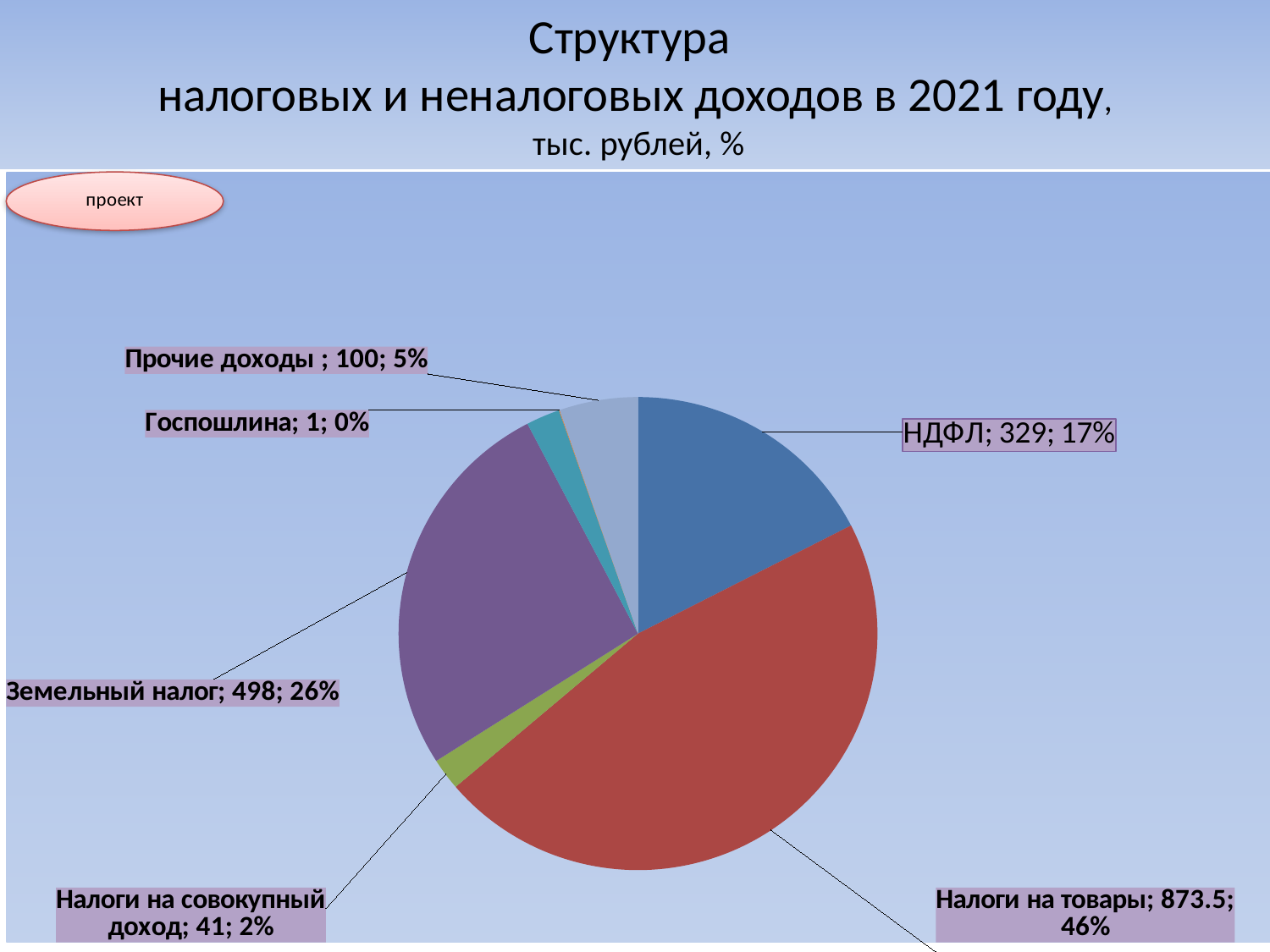
What is the value for Налоги на товары? 873.5 Which category has the smallest slice? Госпошлина What is the value for Земельный налог? 498 What share of the pie does Земельный налог represent? 26% What is the value for Налоги на совокупный доход? 41 Which category has the largest slice? Налоги на товары Which is larger, the value for НДФЛ or the value for Прочие доходы? НДФЛ How many slices does the pie chart have? 7 What is the value for НДФЛ? 329 What share of the pie does Прочие доходы represent? 5% What type of chart is shown on the slide? pie chart What is the difference between the values for Земельный налог and НДФЛ? 169